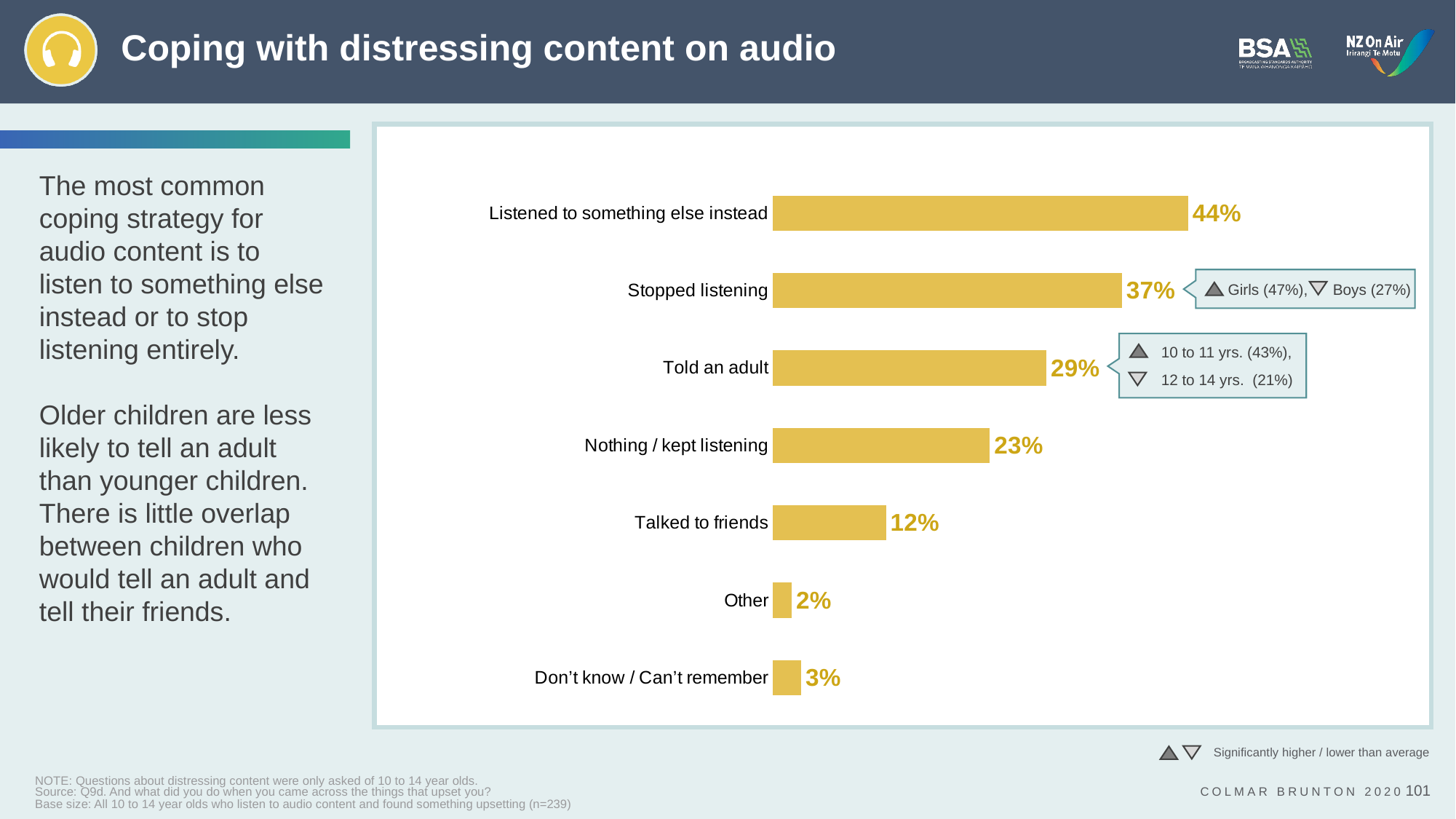
According to the callout, what percentage of girls stopped listening? 47% What is the title of the slide? Coping with distressing content on audio What type of chart is shown on the slide? Bar chart What percentage of children talked to friends? 12% Which coping strategy has the highest percentage? Listened to something else instead What is the value for 'Told an adult'? 29% What percentage of children listened to something else instead? 44% Which category has the lowest percentage? Other Which is larger: 'Told an adult' or 'Talked to friends'? Told an adult How many categories are shown in the chart? 7 What is the difference between 'Listened to something else instead' and 'Stopped listening'? 7% What is the difference between 'Stopped listening' and 'Nothing / kept listening'? 14%